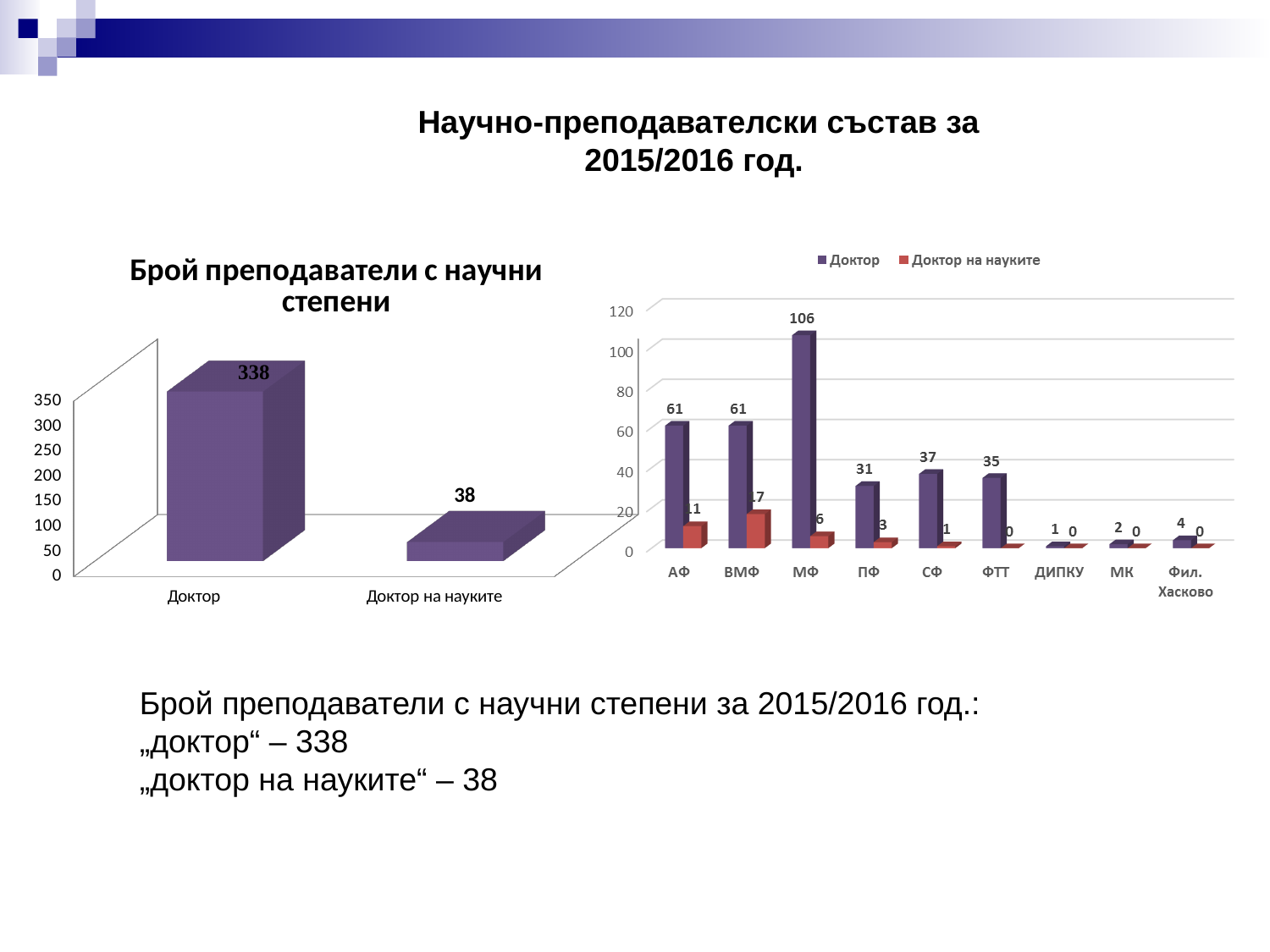
In the right chart, how many categories are shown on the x axis? 9 In the right chart, what is the Доктор value for ФТТ? 35 In the right chart, which category has the highest Доктор value? МФ In the right chart, how many series does the legend list? 2 In the right chart, what is the Доктор value for МФ? 106 In the left chart titled "Брой преподаватели с научни степени", what is the difference between the Доктор and Доктор на науките values? 300 In the left chart titled "Брой преподаватели с научни степени", how many categories are shown? 2 In the left chart titled "Брой преподаватели с научни степени", what is the value for Доктор? 338 In the right chart, what is the Доктор на науките value for ВМФ? 17 What kind of chart is the right chart? Bar chart In the right chart, which is larger: the Доктор value for СФ or for ПФ? СФ In the left chart titled "Брой преподаватели с научни степени", what is the value for Доктор на науките? 38